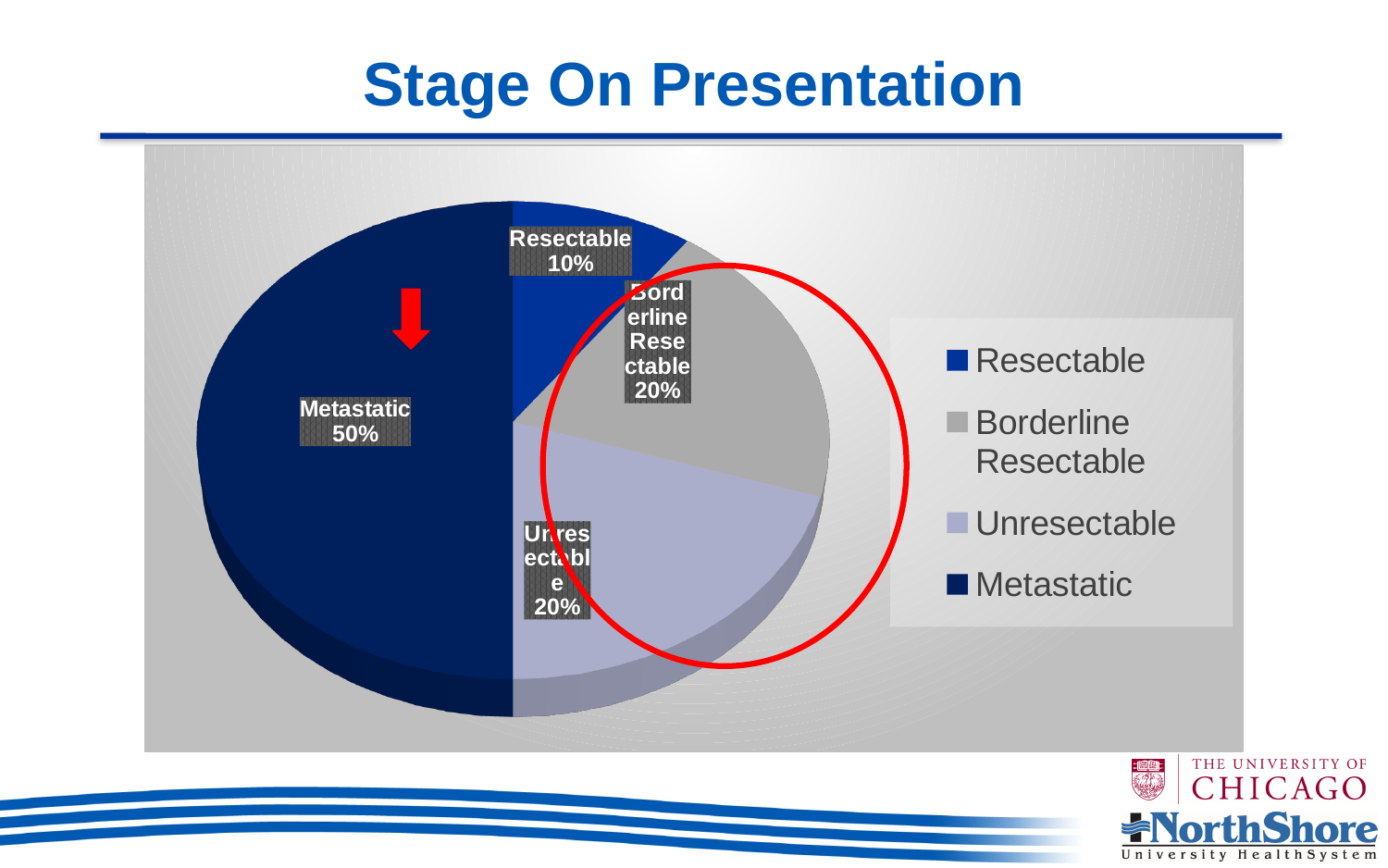
Which category has the smallest share of the pie? Resectable What percentage of the pie is Borderline Resectable? 20% What percentage of the pie is Resectable? 10% What percentage of the pie is Unresectable? 20% What is the difference in percentage points between the Metastatic and Resectable slices? 40 Which is larger, the Metastatic slice or the Unresectable slice? Metastatic What percentage of the pie is Metastatic? 50% How many categories does the legend list? 4 What is the title of the chart? Stage On Presentation What kind of chart is shown on the slide? Pie chart What is the combined share of the Borderline Resectable and Unresectable slices? 40% Which category has the largest share of the pie? Metastatic